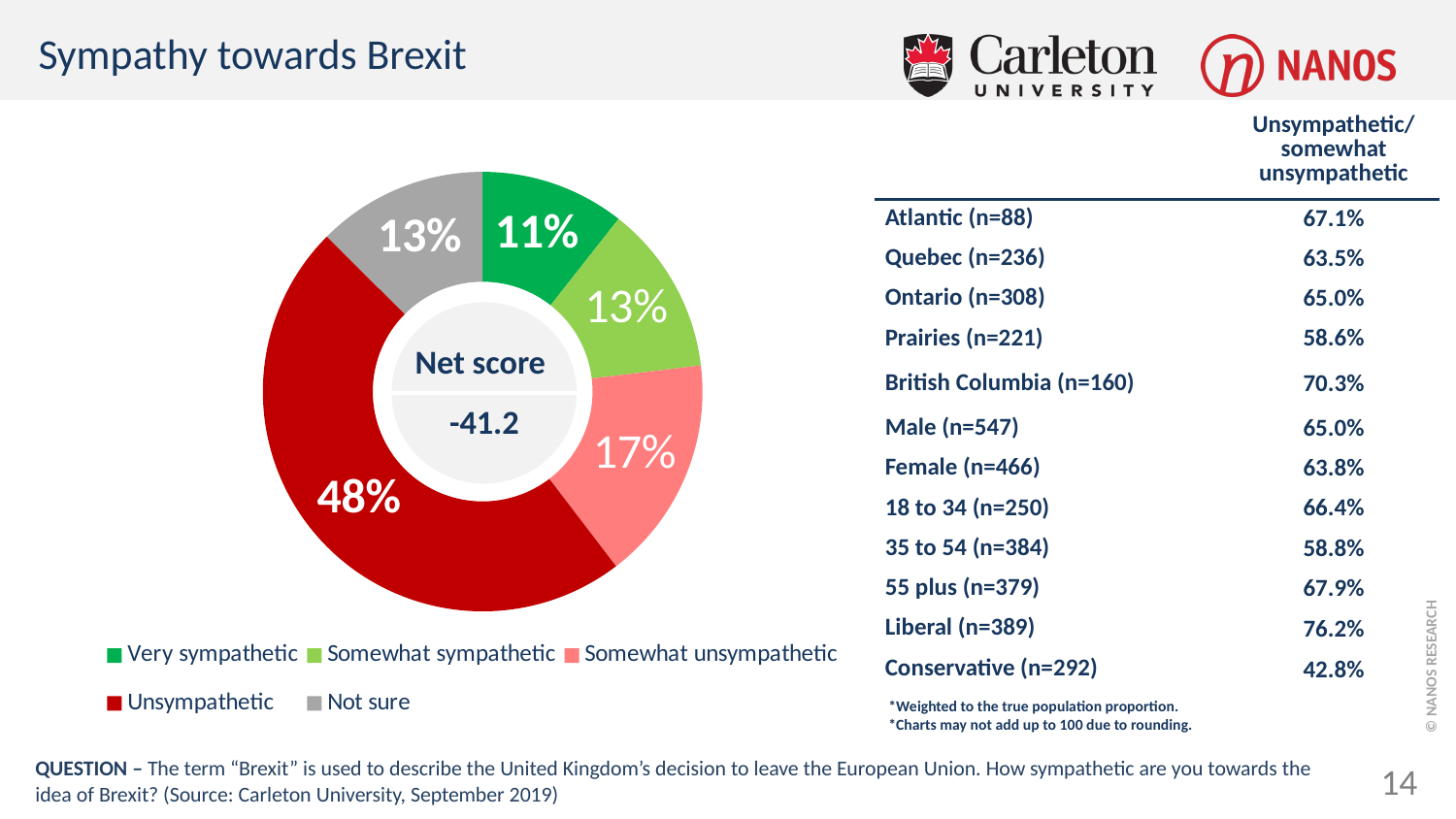
What percentage of respondents are Very sympathetic towards Brexit? 11% What percentage of respondents answered Not sure? 13% What kind of chart is shown on the slide? Pie chart (donut) What percentage of respondents are Unsympathetic towards Brexit? 48% What colour is the Unsympathetic slice of the pie chart? Red What percentage of respondents are Somewhat unsympathetic? 17% Which category has the largest share of the pie? Unsympathetic How many categories does the legend of the pie chart list? 5 What is the difference between the Unsympathetic and Somewhat unsympathetic shares? 31% What net score is shown in the centre of the donut chart? -41.2 Which is larger, the Somewhat unsympathetic share or the Somewhat sympathetic share? Somewhat unsympathetic Which category has the smallest share of the pie? Very sympathetic